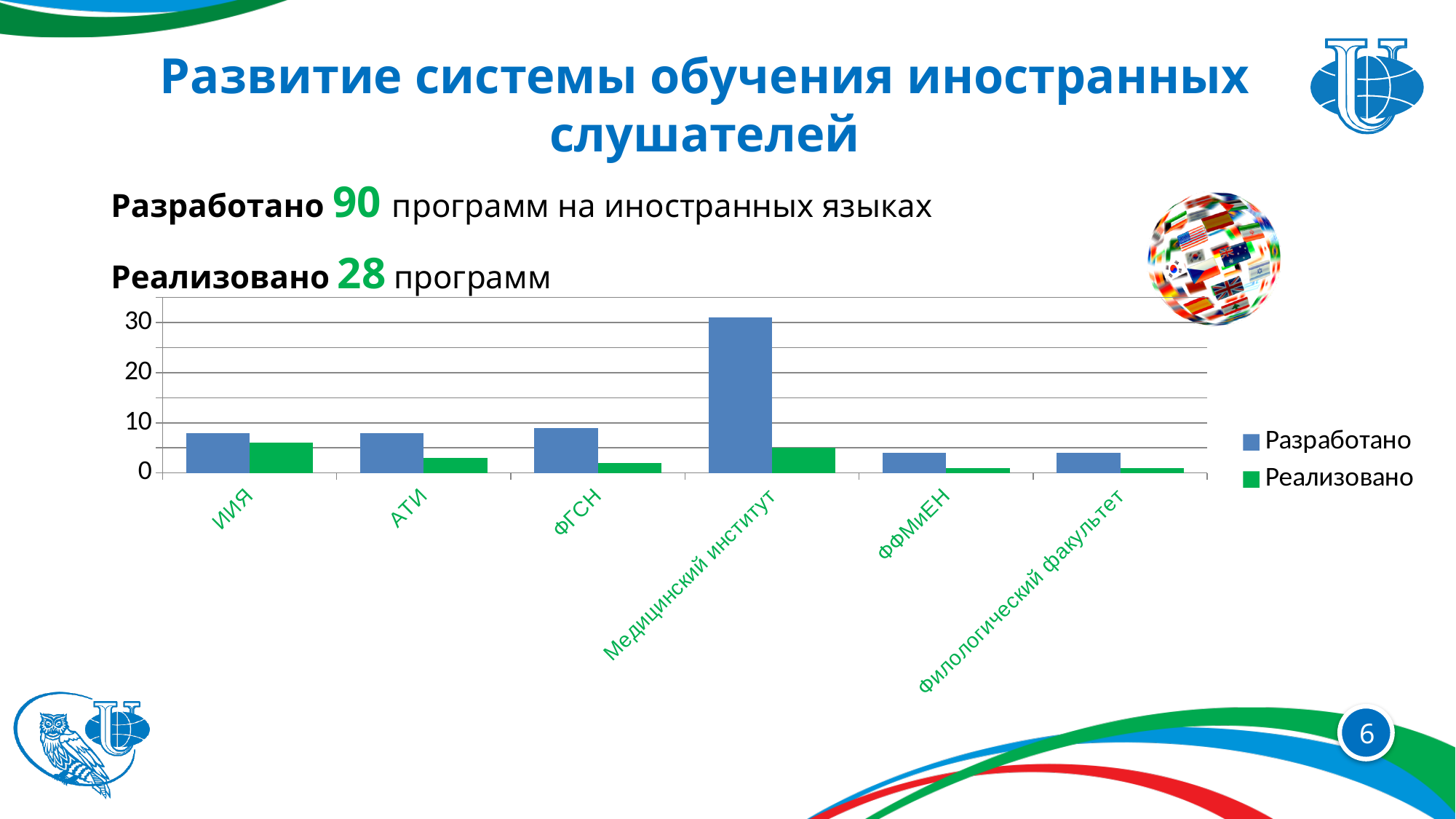
How many series does the chart legend list? 2 Which category has the highest value for Разработано? Медицинский институт Is the Разработано value for Медицинский институт greater or less than 20? greater Which has the larger Разработано value: ФГСН or ФФМиЕН? ФГСН What colour represents the Реализовано series in the chart? green What kind of chart is shown on the slide? bar chart Is the Реализовано value for АТИ greater or less than 10? less Is the Разработано value for ИИЯ greater or less than 10? less For ФГСН, which is larger: Разработано or Реализовано? Разработано Which has the larger Реализовано value: ИИЯ or Филологический факультет? ИИЯ What are the two series names listed in the chart legend? Разработано, Реализовано How many categories (faculties/institutes) are shown on the x axis of the chart? 6